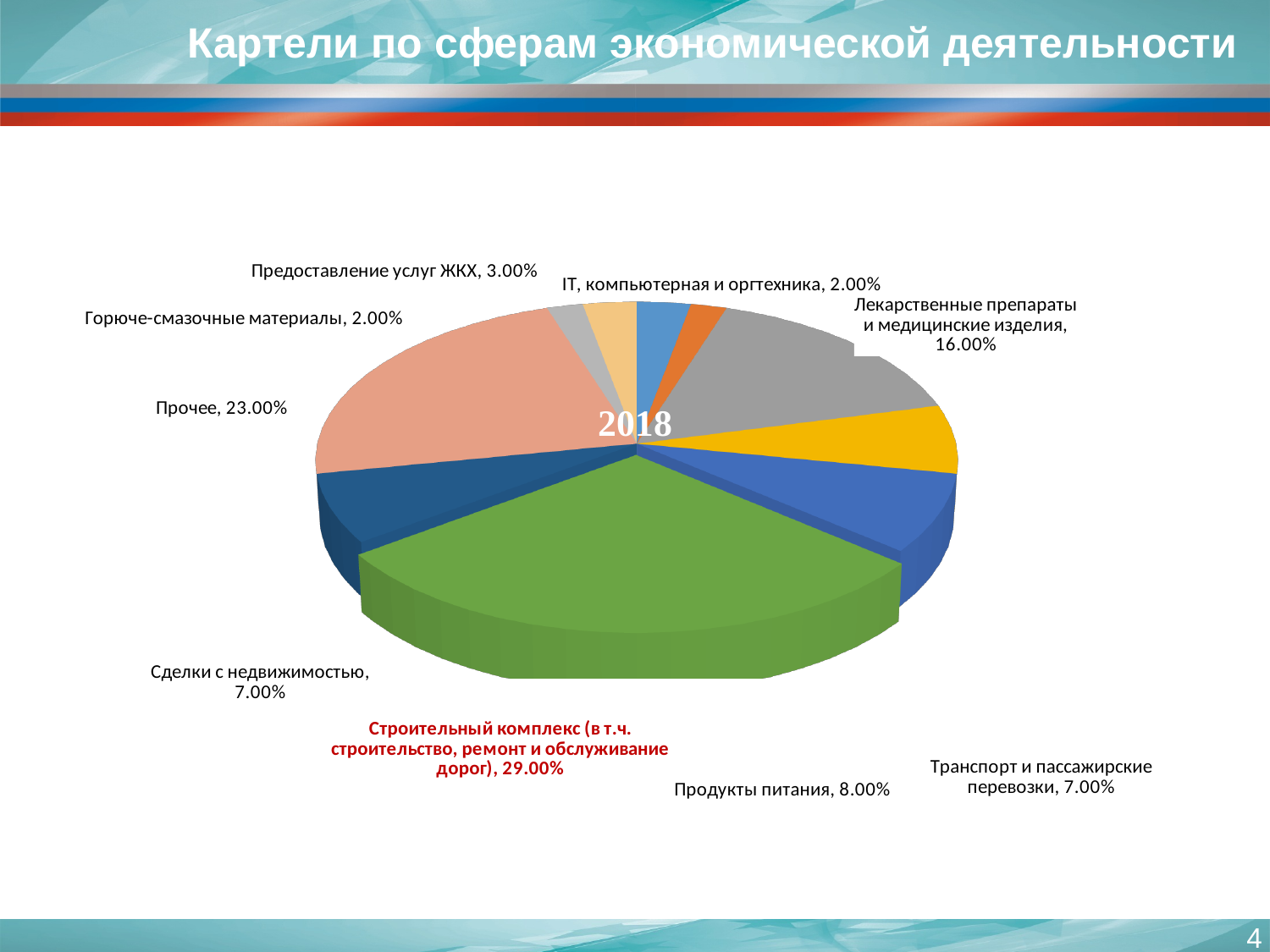
What share does Продукты питания have in the pie chart? 8.00% How many categories are shown in the pie chart? 10 What share does Строительный комплекс (в т.ч. строительство, ремонт и обслуживание дорог) have in the pie chart? 29.00% What kind of chart is shown on the slide? Pie chart What year is written in the centre of the pie chart? 2018 What is the difference between the shares of Прочее and Лекарственные препараты и медицинские изделия? 7.00% Which has a larger share: Продукты питания or Сделки с недвижимостью? Продукты питания What share does Прочее have in the pie chart? 23.00% Which category has the largest share in the pie chart? Строительный комплекс (в т.ч. строительство, ремонт и обслуживание дорог) What share does Предоставление услуг ЖКХ have in the pie chart? 3.00% What share does Лекарственные препараты и медицинские изделия have in the pie chart? 16.00% What is the title of the slide? Картели по сферам экономической деятельности